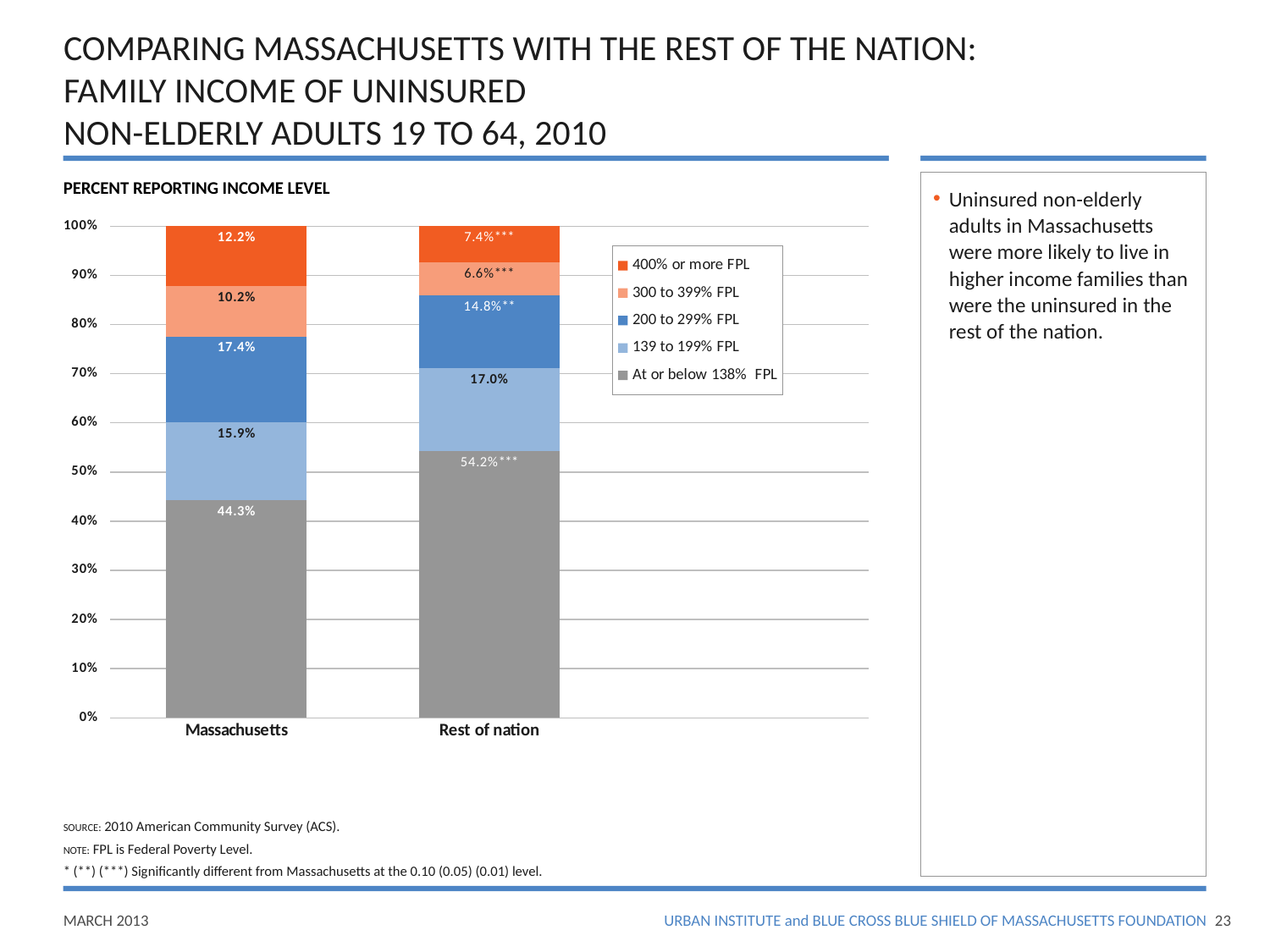
What is the value for 300 to 399% FPL for the rest of the nation? 6.6% Which category has the larger share at or below 138% FPL, Massachusetts or the rest of the nation? Rest of nation What is the value for 200 to 299% FPL for Massachusetts? 17.4% What percentage of uninsured non-elderly adults in Massachusetts are at or below 138% FPL? 44.3% Which income level segment is the smallest for the rest of the nation? 300 to 399% FPL What is the difference between the 400% or more FPL shares for Massachusetts and the rest of the nation? 4.8 percentage points How many categories are shown on the x axis? 2 Which income level segment is the largest for the rest of the nation? At or below 138% FPL How many series does the legend list? 5 What percentage of uninsured non-elderly adults in the rest of the nation are at or below 138% FPL? 54.2% What kind of chart is shown on the slide? Stacked bar chart What is the value for 400% or more FPL for Massachusetts? 12.2%